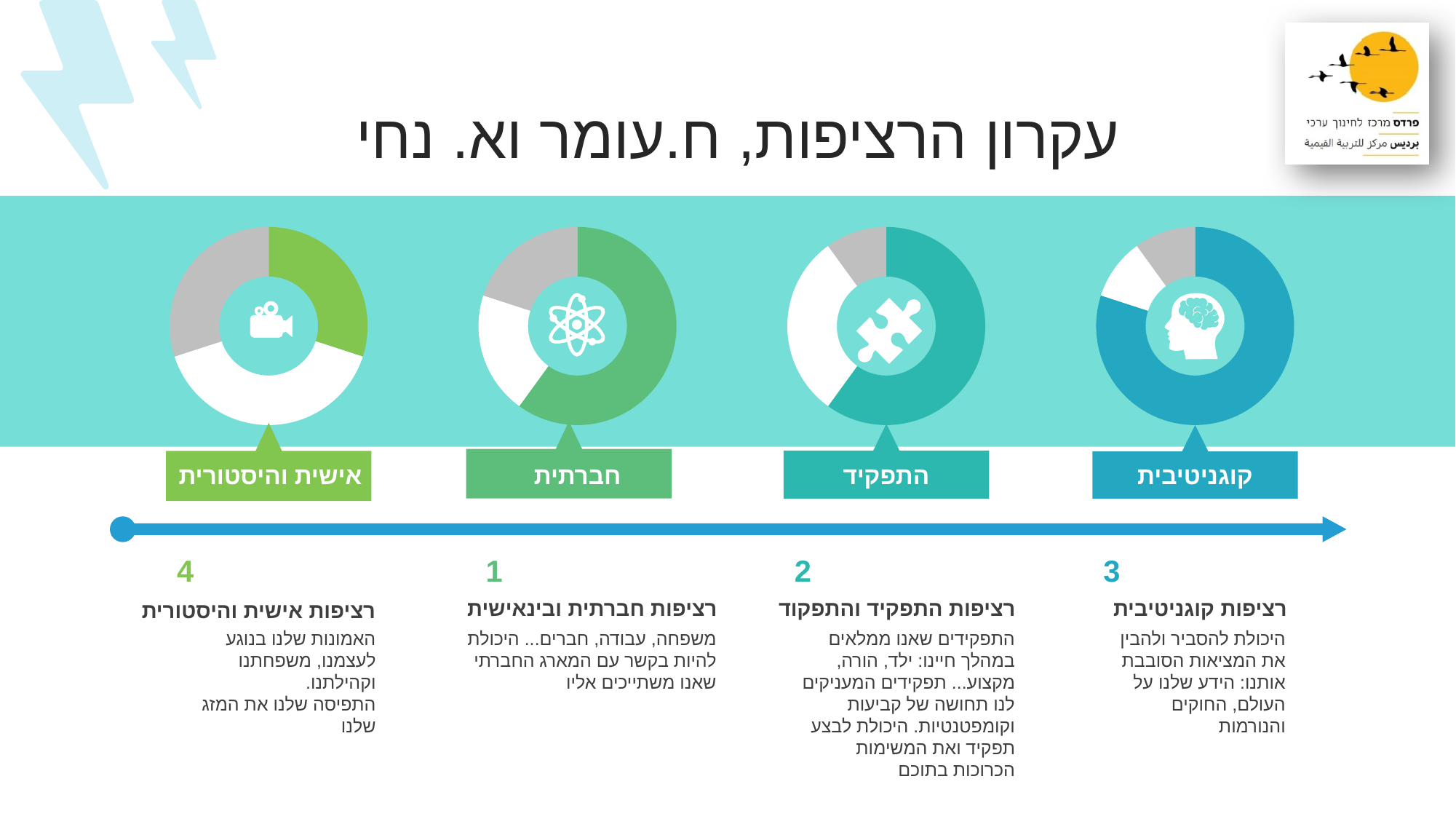
Which donut chart has the smallest coloured segment? אישית והיסטורית Which has a larger coloured segment: the חברתית donut or the אישית והיסטורית donut? חברתית What kind of charts are shown in the teal band across the middle of the slide? Donut (pie) charts How many donut charts are shown on the slide? 4 How many segments does each donut chart have? 3 Which has a larger coloured segment: the התפקיד donut or the אישית והיסטורית donut? התפקיד Which donut chart has the largest coloured segment? קוגניטיבית Which has a larger coloured segment: the קוגניטיבית donut or the אישית והיסטורית donut? קוגניטיבית What colour is the main segment of the donut chart labelled אישית והיסטורית? Green (light green) What label appears under the donut chart with the brain icon? קוגניטיבית